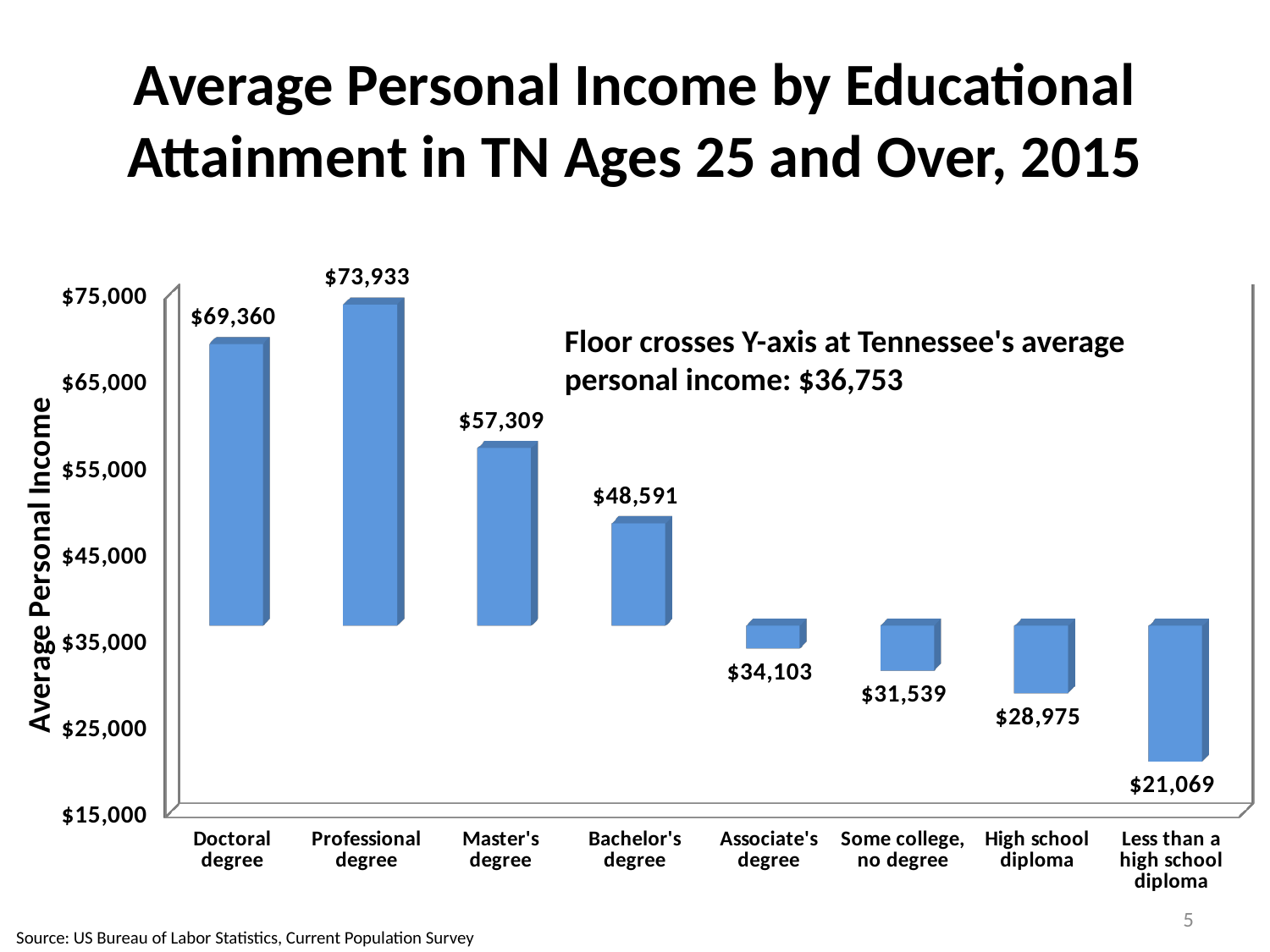
What is the average personal income for Some college, no degree? $31,539 What is the difference in average personal income between a Professional degree and a Doctoral degree? $4,573 What kind of chart is shown on the slide? Bar chart How many educational attainment categories are shown on the chart? 8 Which has a higher average personal income, a Doctoral degree or a Master's degree? Doctoral degree What is the average personal income for a Master's degree? $57,309 Is the average personal income for an Associate's degree greater or less than $35,000? less Which educational attainment category has the highest average personal income? Professional degree Which educational attainment category has the lowest average personal income? Less than a high school diploma At what value does the chart's floor cross the Y-axis, according to the annotation? $36,753 What is the difference in average personal income between a Bachelor's degree and an Associate's degree? $14,488 What is the average personal income for a High school diploma? $28,975